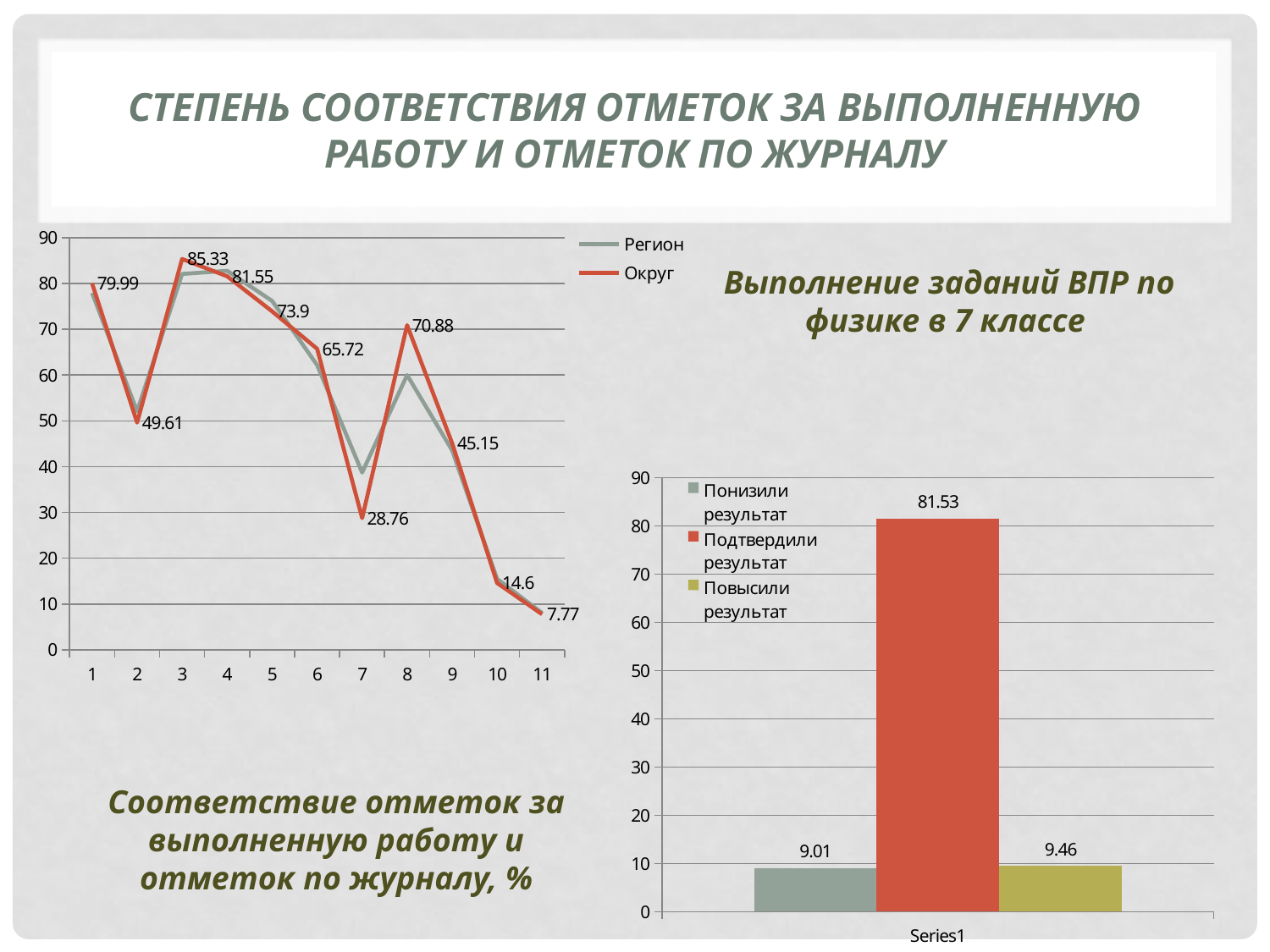
In the bar chart on the right, what is the value for Понизили результат? 9.01 In the line chart on the left, what is the value for Округ at point 3? 85.33 In the line chart on the left, how many series does the legend list? 2 In the bar chart on the right, how many categories does the legend list? 3 In the line chart on the left, how many points are on the x axis? 11 In the bar chart on the right, what is the value for Повысили результат? 9.46 What kind of chart is the chart on the right of the slide? bar chart In the line chart on the left, what is the value for Округ at point 11? 7.77 In the bar chart on the right, what is the value for Подтвердили результат? 81.53 In the bar chart on the right, what is the difference between Подтвердили результат and Повысили результат? 72.07 In the bar chart on the right, which category has the highest value? Подтвердили результат In the line chart on the left, is the value for Регион at point 7 greater or less than 30? greater